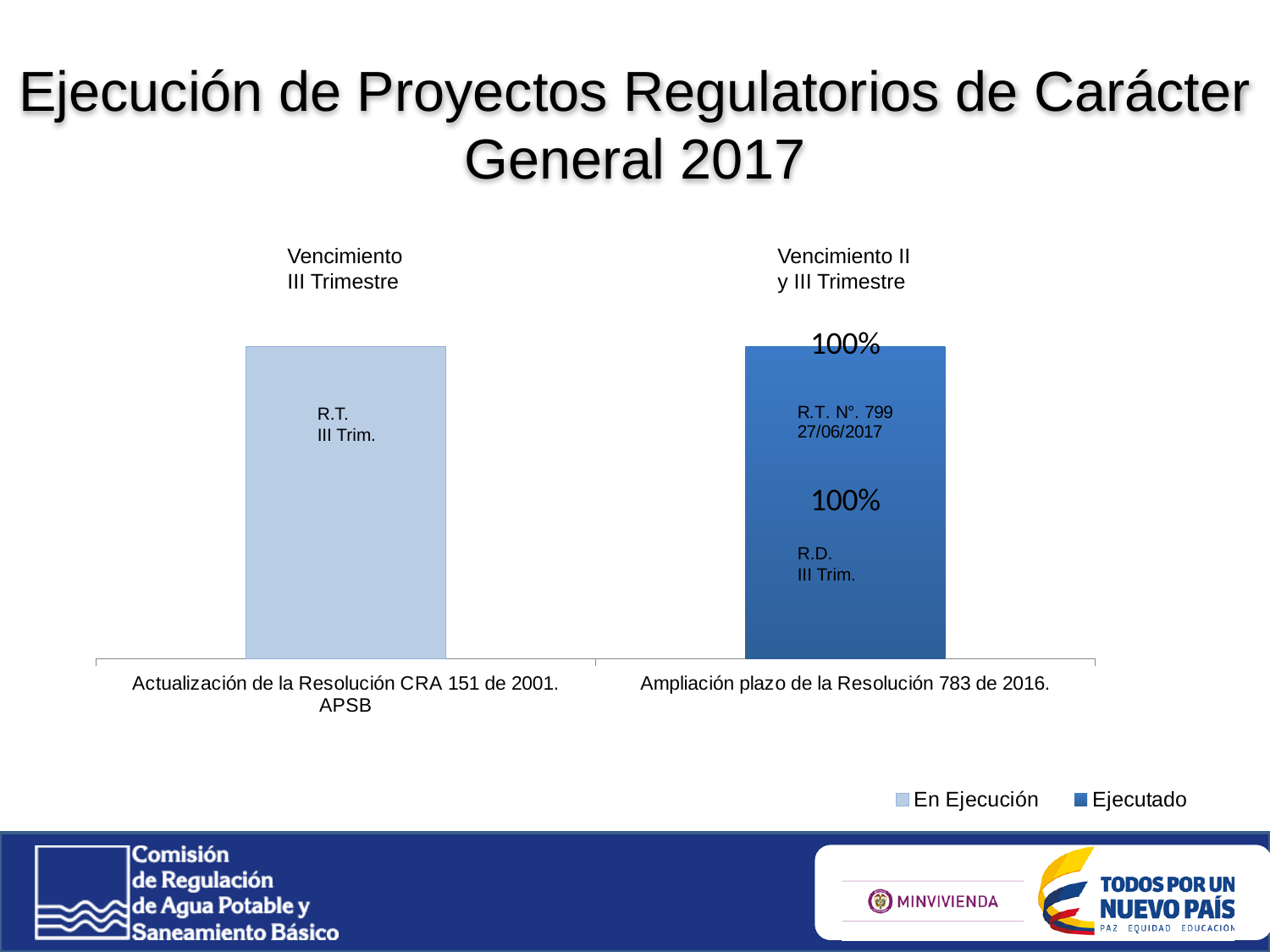
What resolution number and date are printed inside the bar for 'Ampliación plazo de la Resolución 783 de 2016.'? R.T. N°. 799 27/06/2017 What kind of chart is shown on the slide? bar chart What percentage is printed on the bar for 'Ampliación plazo de la Resolución 783 de 2016.'? 100% What label is printed inside the bar for 'Actualización de la Resolución CRA 151 de 2001. APSB'? R.T. III Trim. What are the two series named in the chart legend? En Ejecución and Ejecutado How many series does the chart legend list? 2 How many categories are shown on the x axis of the chart? 2 What text appears above the bar for 'Actualización de la Resolución CRA 151 de 2001. APSB'? Vencimiento III Trimestre Which series does the bar for 'Actualización de la Resolución CRA 151 de 2001. APSB' belong to, according to the legend colours? En Ejecución What text appears above the bar for 'Ampliación plazo de la Resolución 783 de 2016.'? Vencimiento II y III Trimestre